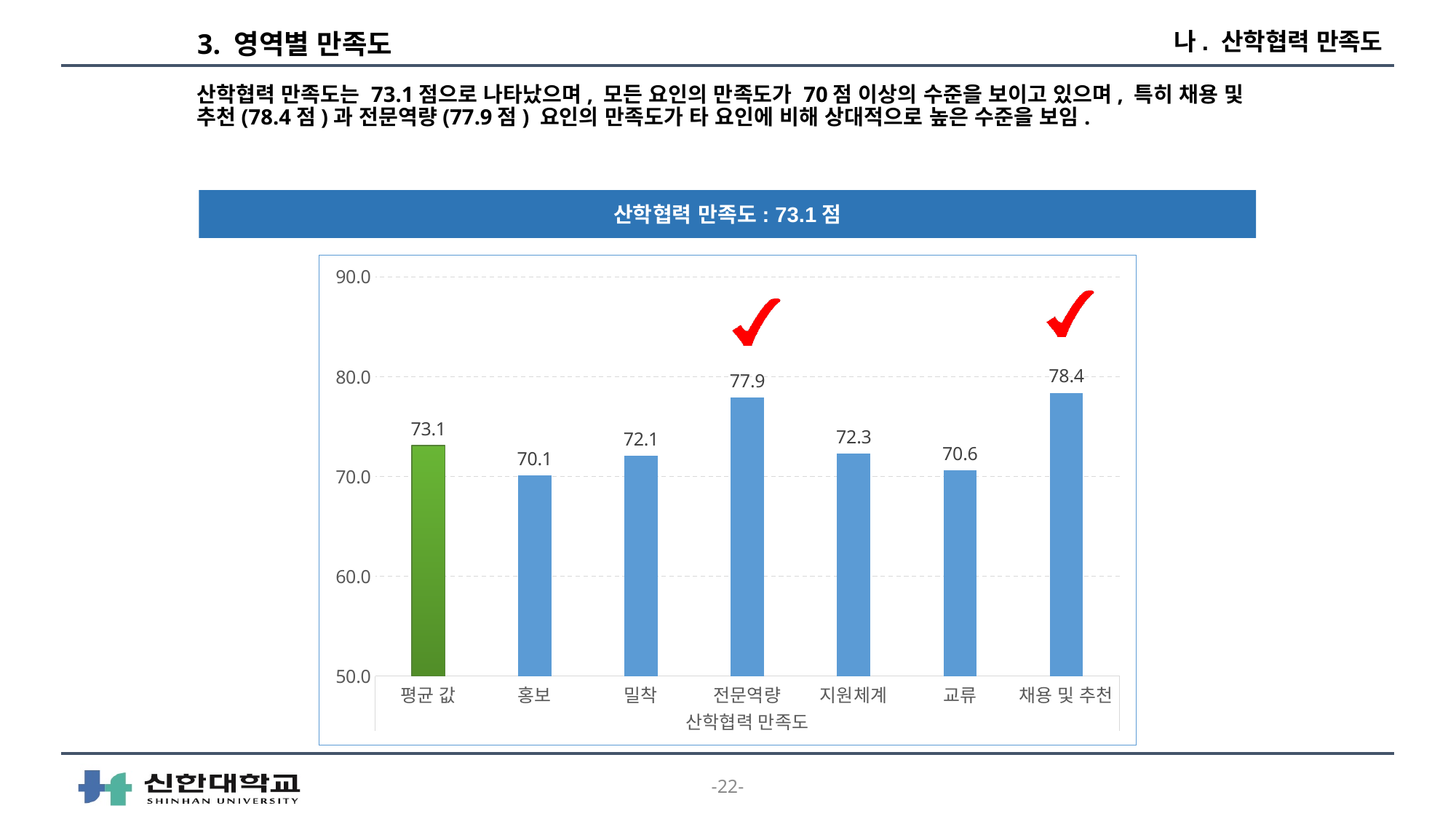
Which category has the highest value? 채용 및 추천 Which category has the lowest value? 홍보 How many categories are shown on the x axis? 7 What is the difference between 지원체계 and 교류? 1.7 What is the difference between 채용 및 추천 and 전문역량? 0.5 What is the value for 평균 값? 73.1 Is the value for 채용 및 추천 greater or less than 80.0? less What kind of chart is this? bar chart What is the value for 홍보? 70.1 What is the value for 전문역량? 77.9 What is the x-axis title of the chart? 산학협력 만족도 Which is larger, 밀착 or 교류? 밀착